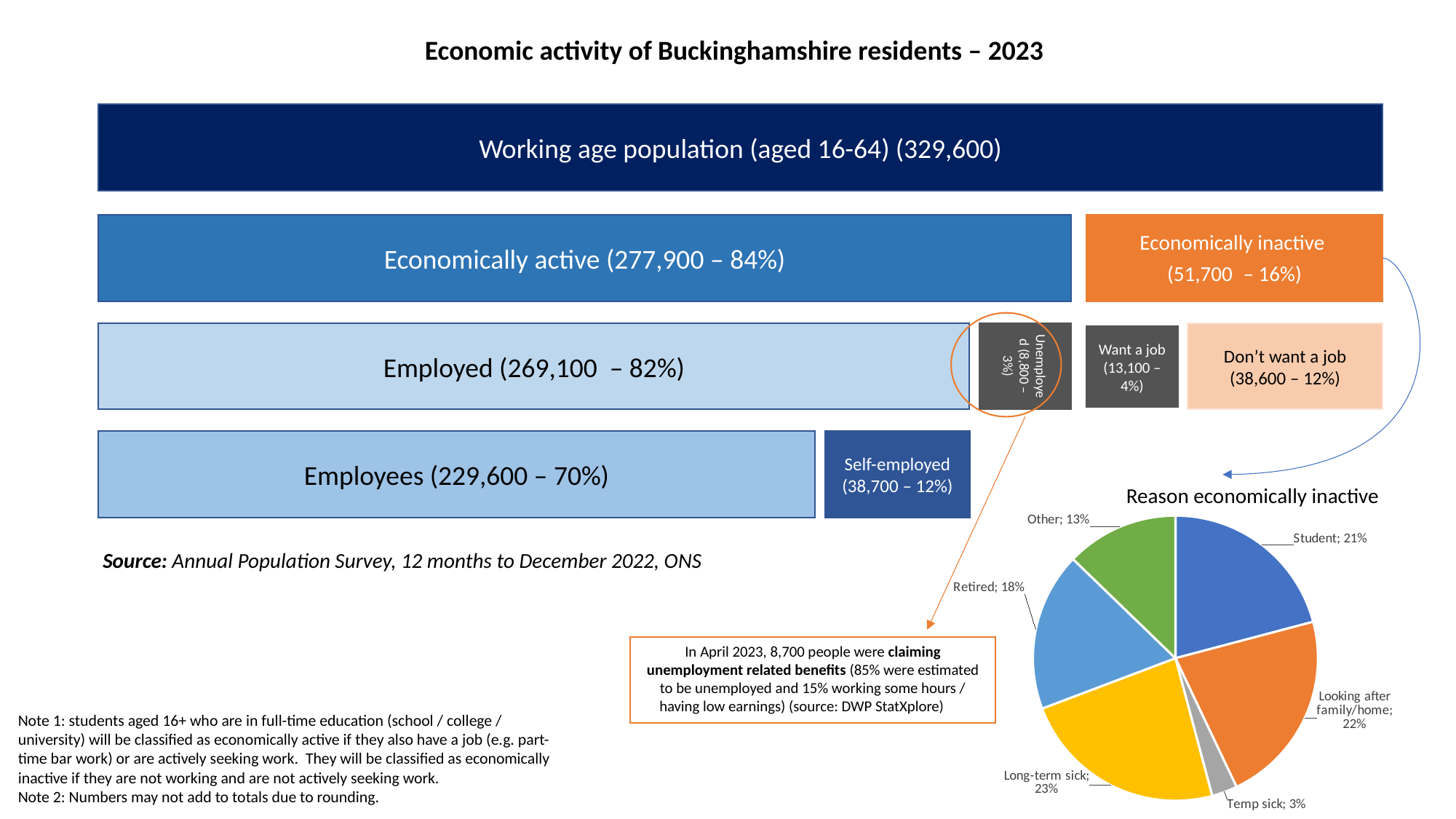
In the economic activity diagram, what is the number and percentage shown for Self-employed? 38,700 – 12% In the 'Reason economically inactive' pie chart, what share is Long-term sick? 23% In the 'Reason economically inactive' pie chart, how many slices are there? 6 In the 'Reason economically inactive' pie chart, what share is Retired? 18% In the 'Reason economically inactive' pie chart, what colour is the Other slice? green In the 'Reason economically inactive' pie chart, what is the difference in percentage points between Student and Retired? 3 In the 'Reason economically inactive' pie chart, which is larger: Student or Other? Student In the 'Reason economically inactive' pie chart, which reason has the smallest share? Temp sick In the 'Reason economically inactive' pie chart, what is the combined share of Student and Looking after family/home? 43% What kind of chart is the 'Reason economically inactive' chart? pie chart In the 'Reason economically inactive' pie chart, what share is Looking after family/home? 22% In the 'Reason economically inactive' pie chart, which reason has the largest share? Long-term sick